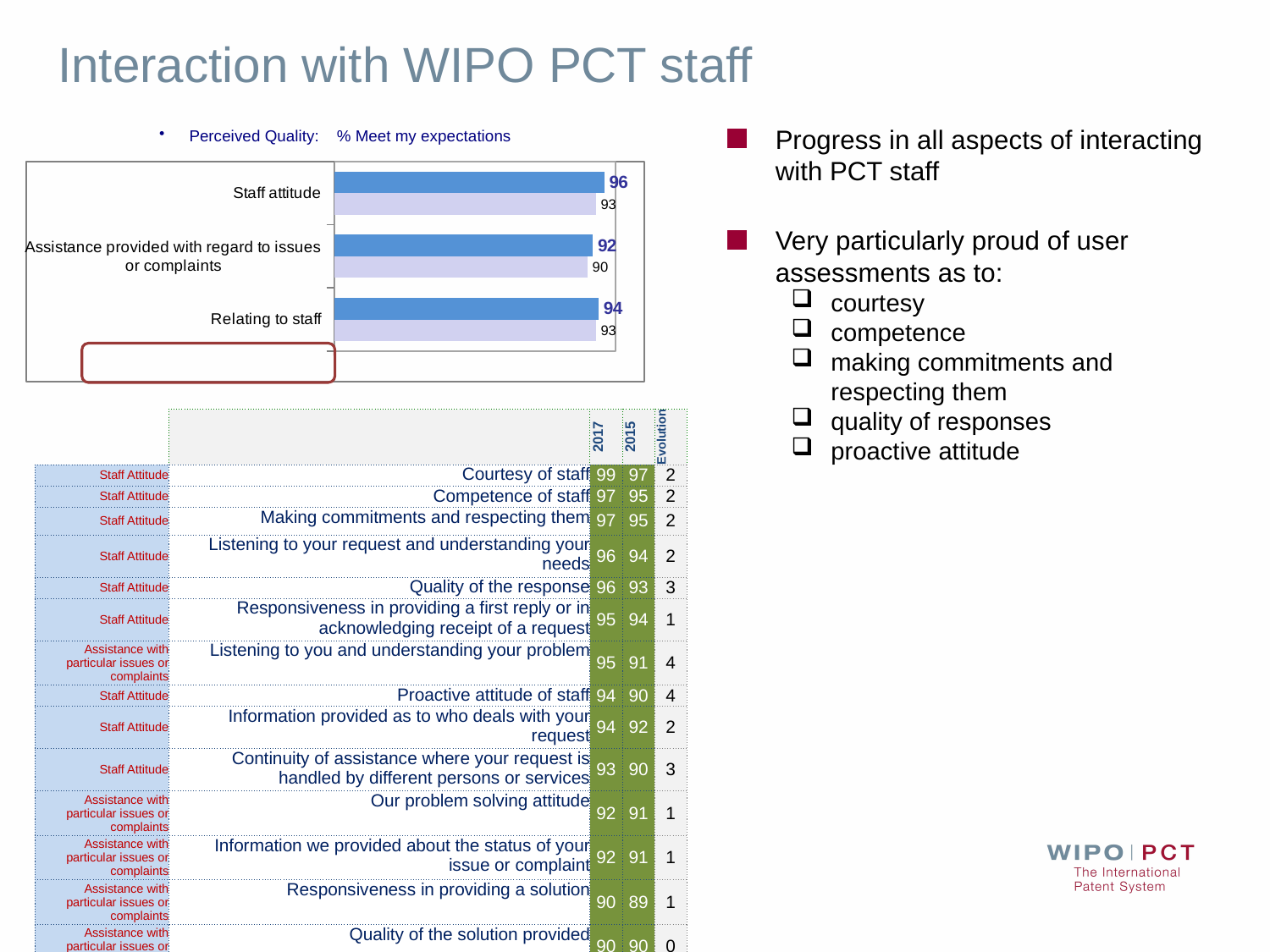
What is the value of the dark blue bar for Assistance provided with regard to issues or complaints? 92 What is the value of the dark blue bar for Staff attitude? 96 How many categories are shown in the bar chart? 3 Which has the larger dark blue bar value: Relating to staff or Assistance provided with regard to issues or complaints? Relating to staff What is the difference between the dark blue and light purple bar values for Staff attitude? 3 What is the value of the light purple bar for Relating to staff? 93 What type of chart is shown on the slide? Bar chart What is the value of the light purple bar for Assistance provided with regard to issues or complaints? 90 Which category has the highest dark blue bar value? Staff attitude What is the value of the dark blue bar for Relating to staff? 94 Which category has the lowest dark blue bar value? Assistance provided with regard to issues or complaints What is the value of the light purple bar for Staff attitude? 93